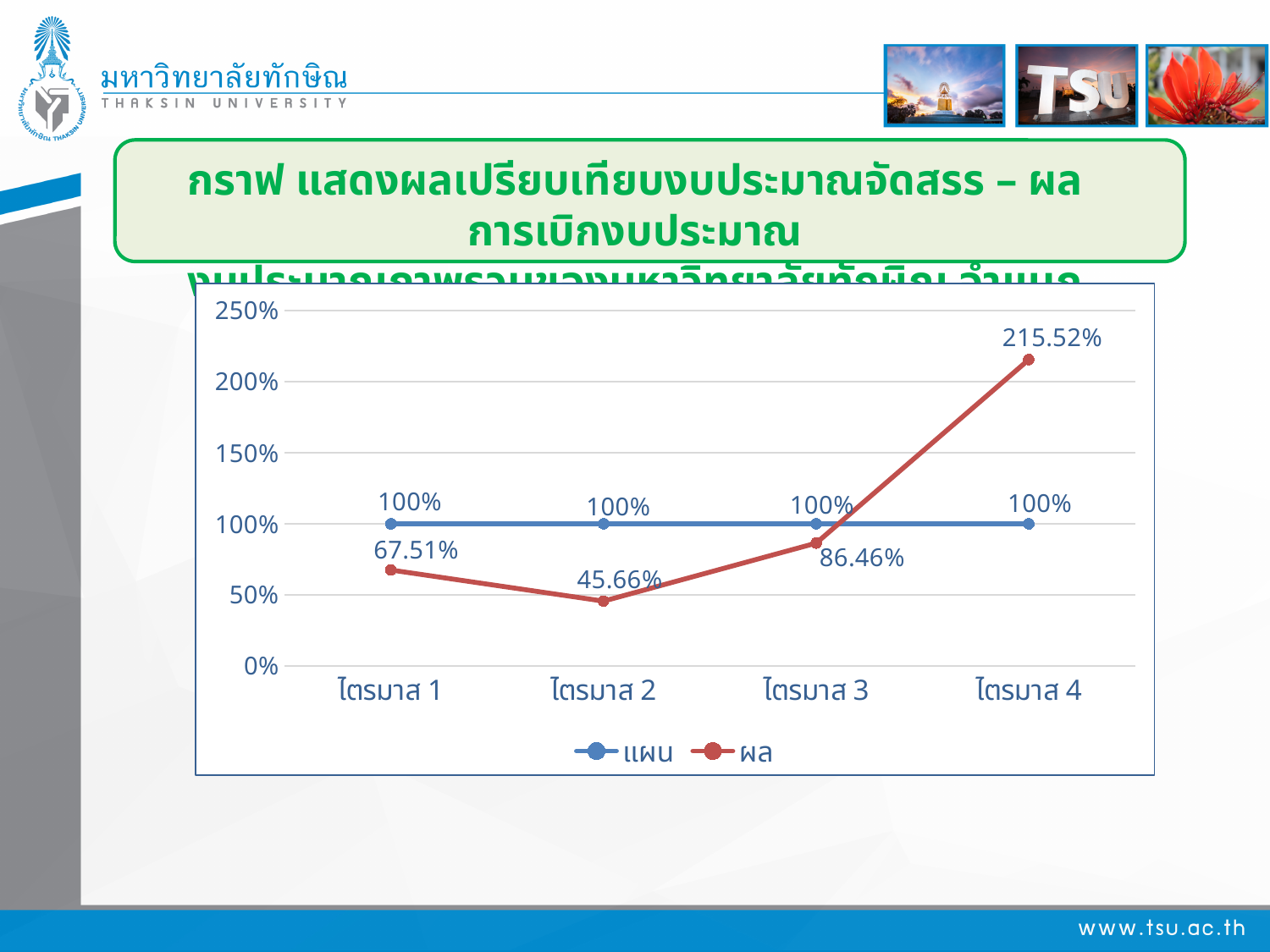
What is the value of ผล for ไตรมาส 4? 215.52% Does the ผล series rise or fall from ไตรมาส 2 to ไตรมาส 4? rise How many quarters are shown on the x axis? 4 Which is larger for ไตรมาส 1: the แผน value or the ผล value? แผน What is the value of ผล for ไตรมาส 1? 67.51% In which quarter is the ผล value highest? ไตรมาส 4 In which quarter is the ผล value lowest? ไตรมาส 2 What is the value of ผล for ไตรมาส 2? 45.66% What is the value of แผน for ไตรมาส 3? 100% What kind of chart is shown on the slide? line chart How many series does the legend list? 2 What is the difference between the ผล value for ไตรมาส 4 and the ผล value for ไตรมาส 3? 129.06%